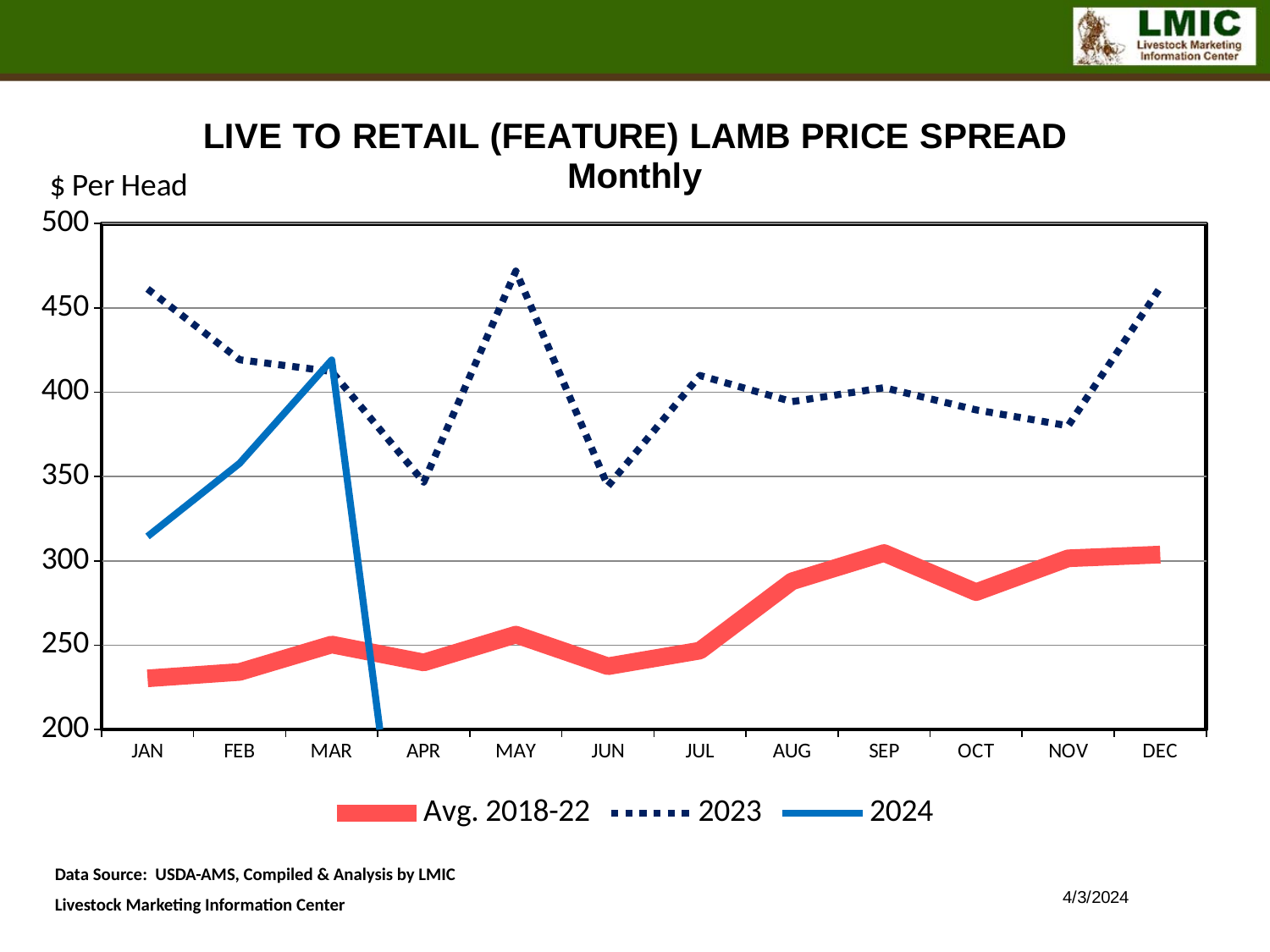
Is the value for 2023 in JUN greater or less than 400? less How many months are shown along the x axis? 12 Is the value for 2024 in JAN greater or less than 300? greater What unit label is shown above the y axis? $ Per Head What kind of chart is shown on the slide? line chart Is the value for Avg. 2018-22 in JAN greater or less than 250? less How many series does the legend list? 3 In which month does the 2023 series reach its highest value? MAY Does the 2024 series rise or fall from JAN to MAR? rise Which is larger in JAN: the 2023 value or the Avg. 2018-22 value? 2023 Which is larger in MAR: the 2024 value or the Avg. 2018-22 value? 2024